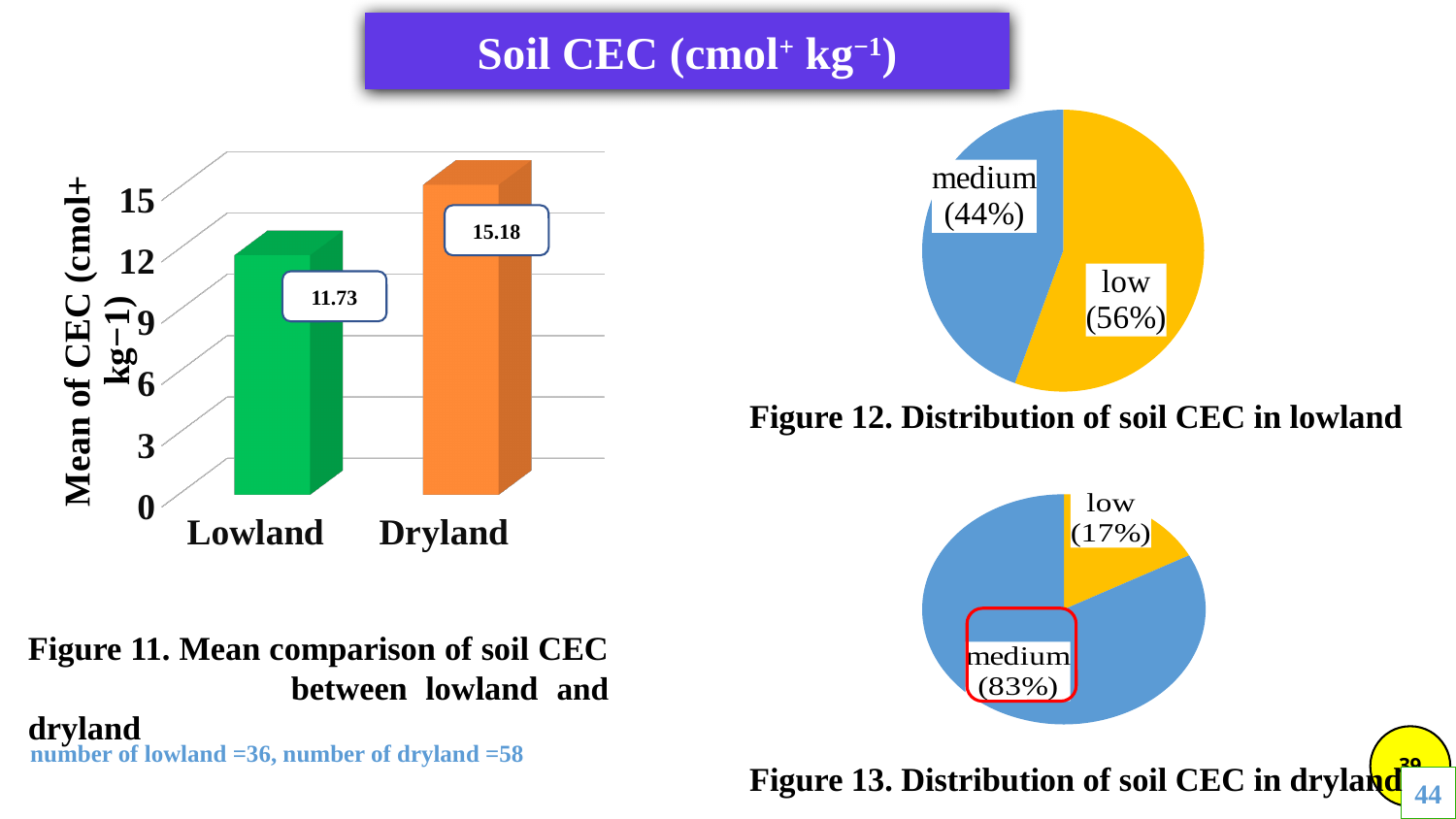
In Figure 13, which category has the smaller slice? low In Figure 11, what is the mean CEC value for Dryland? 15.18 What is the title of Figure 13? Distribution of soil CEC in dryland In Figure 12, what share of the pie is the medium category? 44% In Figure 12, what share of the pie is the low category? 56% What kind of chart is Figure 11? bar chart In Figure 11, is the value for Lowland greater or less than 12? less In Figure 13, what share of the pie is the medium category? 83% In Figure 11, which category has the higher mean CEC? Dryland In Figure 11, how many categories are shown on the x axis? 2 In Figure 11, what is the difference between the Dryland and Lowland mean CEC values? 3.45 In Figure 11, what is the mean CEC value for Lowland? 11.73